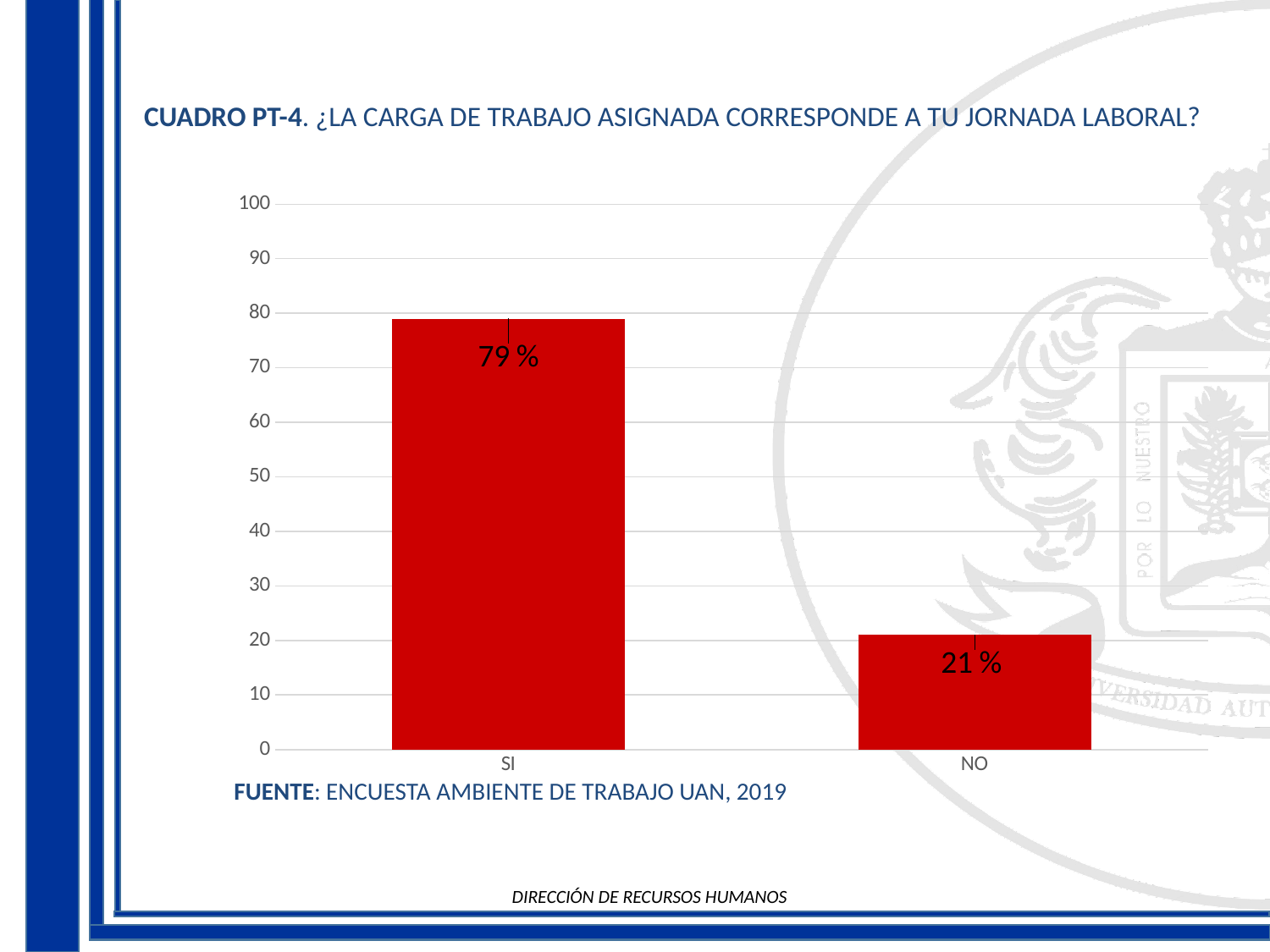
Which category has the lowest value? NO Which category has the highest value? SI What kind of chart is shown on the slide? bar chart Which is larger, the value for SI or the value for NO? SI What is the difference between the values for SI and NO? 58 % Is the value for NO greater or less than 30? less What colour are the bars in the chart? red What is the value for NO? 21 % How many categories are shown on the x axis? 2 What is the value for SI? 79 % Is the value for SI greater or less than 70? greater What is the source cited below the chart? ENCUESTA AMBIENTE DE TRABAJO UAN, 2019